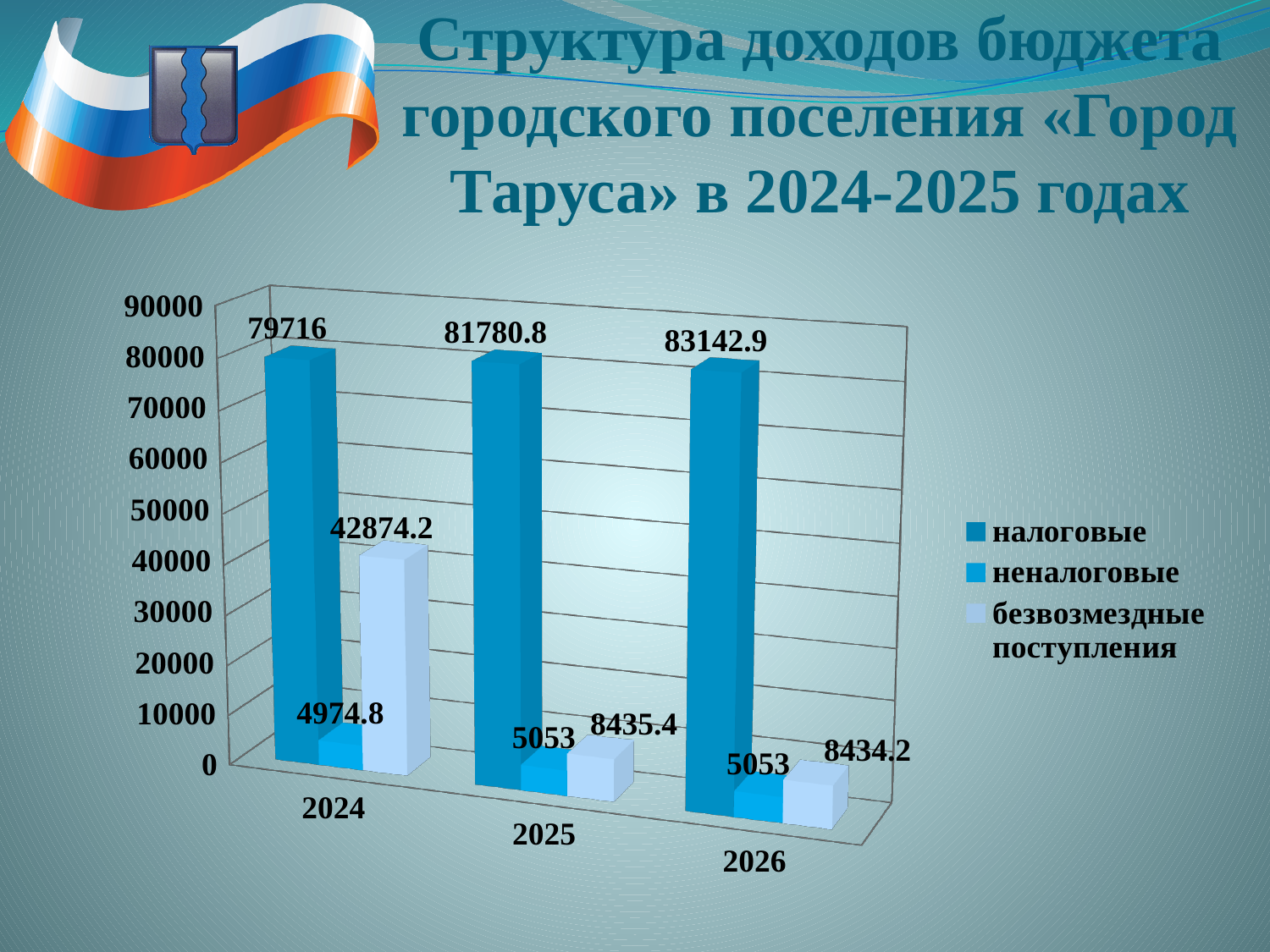
In which year is the неналоговые value lowest? 2024 What is the value of безвозмездные поступления for 2024? 42874.2 Which is larger: безвозмездные поступления for 2025 or for 2026? 2025 How many series does the legend list? 3 What is the value of налоговые for 2024? 79716 What is the difference between the налоговые values for 2026 and 2024? 3426.9 What is the value of безвозмездные поступления for 2026? 8434.2 How many years are shown on the x axis? 3 In which year is the налоговые value highest? 2026 What kind of chart is shown on the slide? bar chart Do the налоговые values rise or fall from 2024 to 2026? rise What is the value of неналоговые for 2025? 5053